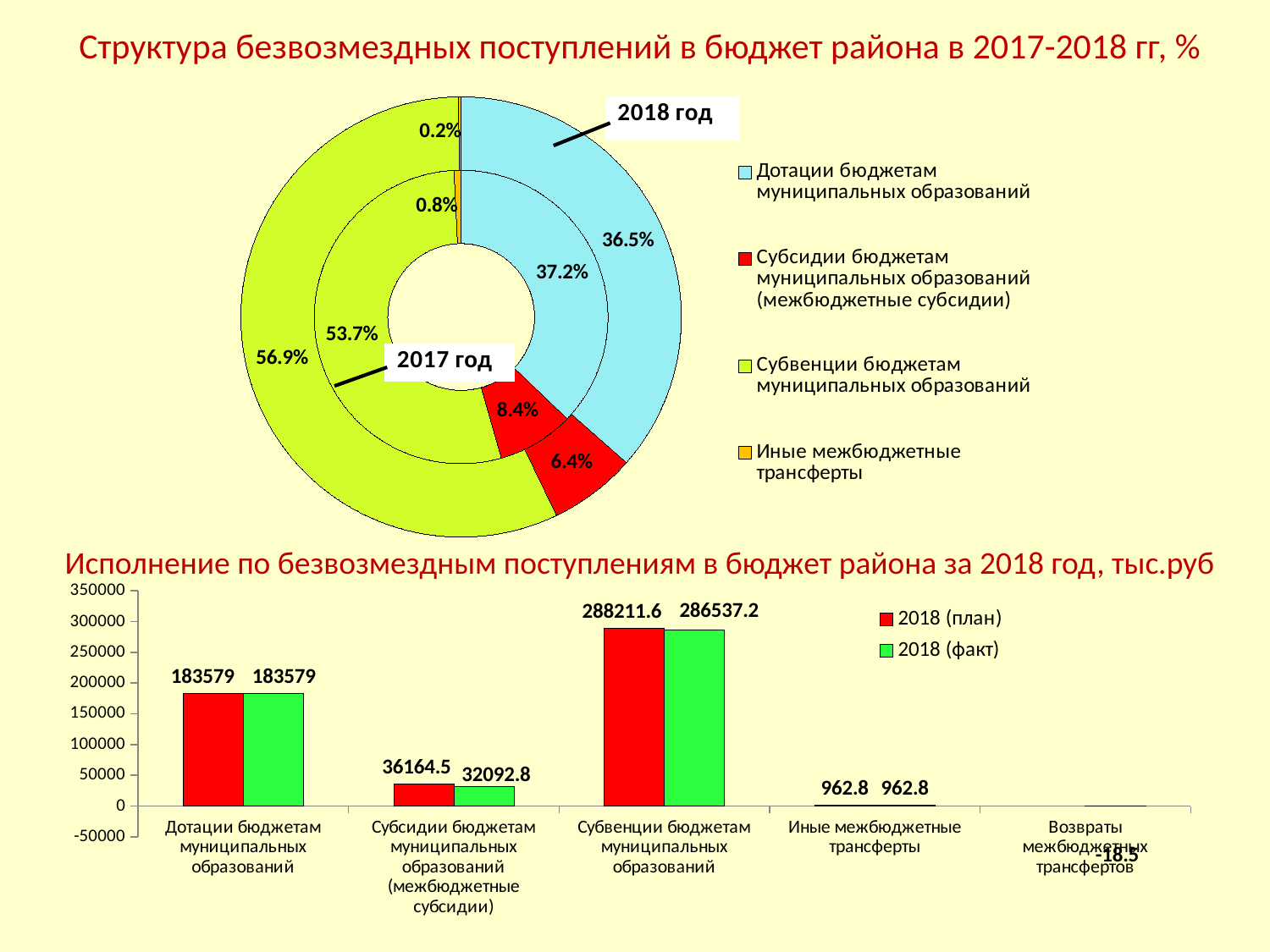
How many categories are shown on the x axis of the bottom bar chart? 5 In the bottom bar chart, what is the difference between the 2018 (план) and 2018 (факт) values for Субвенции бюджетам муниципальных образований? 1674.4 In the top doughnut chart, what share did Иные межбюджетные трансферты have in 2018? 0.2% In the top doughnut chart, what share did Субвенции бюджетам муниципальных образований have in 2018? 56.9% In the top doughnut chart, which category had the smallest share in 2017? Иные межбюджетные трансферты How many categories does the legend of the top doughnut chart list? 4 In the top doughnut chart, by how many percentage points did the share of Субсидии бюджетам муниципальных образований change from 2017 (8.4%) to 2018 (6.4%)? 2.0 percentage points What type of chart is the bottom chart on the slide? Bar chart In the bottom bar chart, which category has the highest 2018 (факт) value? Субвенции бюджетам муниципальных образований In the top doughnut chart, what share did Дотации бюджетам муниципальных образований have in 2017? 37.2% In the bottom bar chart, what is the 2018 (факт) value for Субсидии бюджетам муниципальных образований? 32092.8 In the bottom bar chart, what is the 2018 (план) value for Субвенции бюджетам муниципальных образований? 288211.6